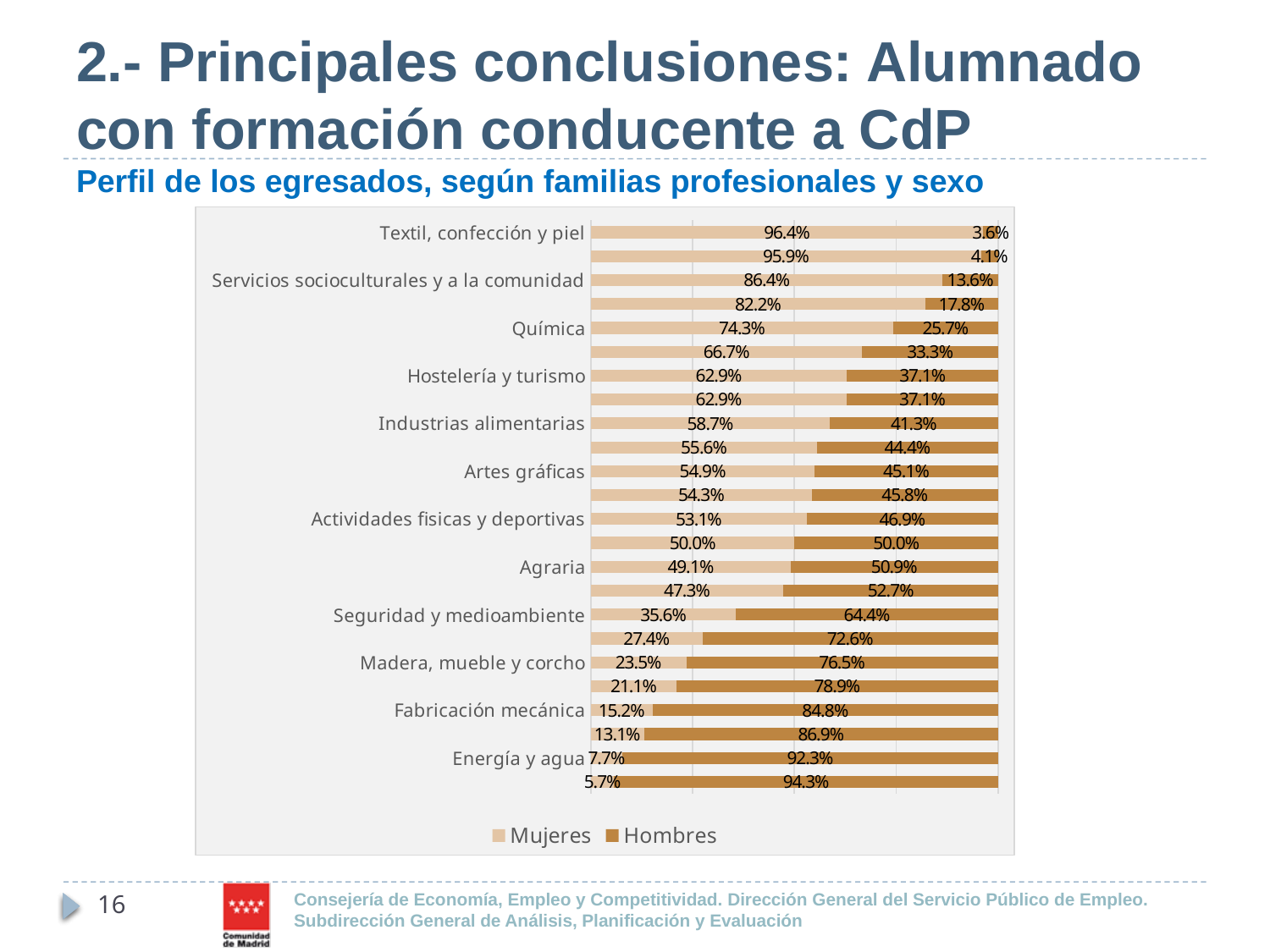
For Agraria, which is larger, the Mujeres share or the Hombres share? Hombres Which labelled category has the highest Mujeres share? Textil, confección y piel Going from the top of the chart to the bottom, do the Mujeres shares rise or fall? Fall What kind of chart is shown on the slide? Stacked horizontal bar chart What is the difference between the Mujeres and Hombres shares for Textil, confección y piel? 92.8 percentage points What is the Hombres value for Energía y agua? 92.3% What is the difference between the Mujeres and Hombres shares for Química? 48.6 percentage points What is the Mujeres value for Química? 74.3% What are the two series named in the legend? Mujeres and Hombres How many series does the legend list? 2 What is the Hombres value for Seguridad y medioambiente? 64.4% What is the Mujeres value for Textil, confección y piel? 96.4%